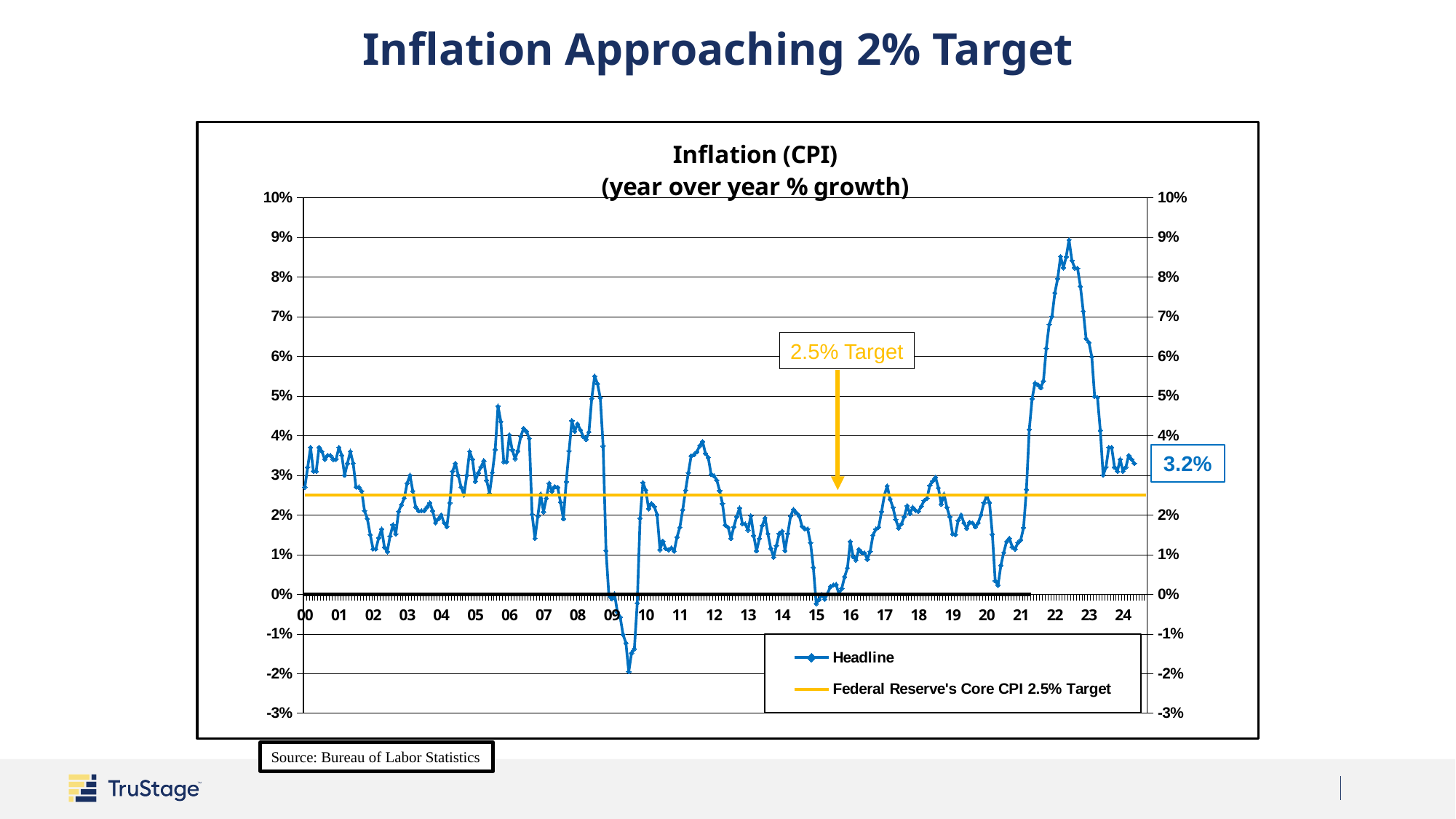
Is the peak Headline inflation value in 2022 greater or less than 8%? greater How many series does the legend list? 2 Which peak is higher: the Headline inflation peak in 2008 or the peak in 2022? 2022 What is the title of the chart? Inflation (CPI) (year over year % growth) Is the lowest Headline inflation value in 2009 greater or less than -1%? less What are the two entries in the chart legend? Headline; Federal Reserve's Core CPI 2.5% Target In which year does the Headline inflation line reach its lowest point? 09 Does the Headline inflation line rise or fall from its 2022 peak to 2024? Fall In which year does the Headline inflation line reach its highest point? 22 What kind of chart is shown on the slide? Line chart What is the most recent Headline inflation value labeled on the chart? 3.2% What value does the Federal Reserve's Core CPI target line represent? 2.5%